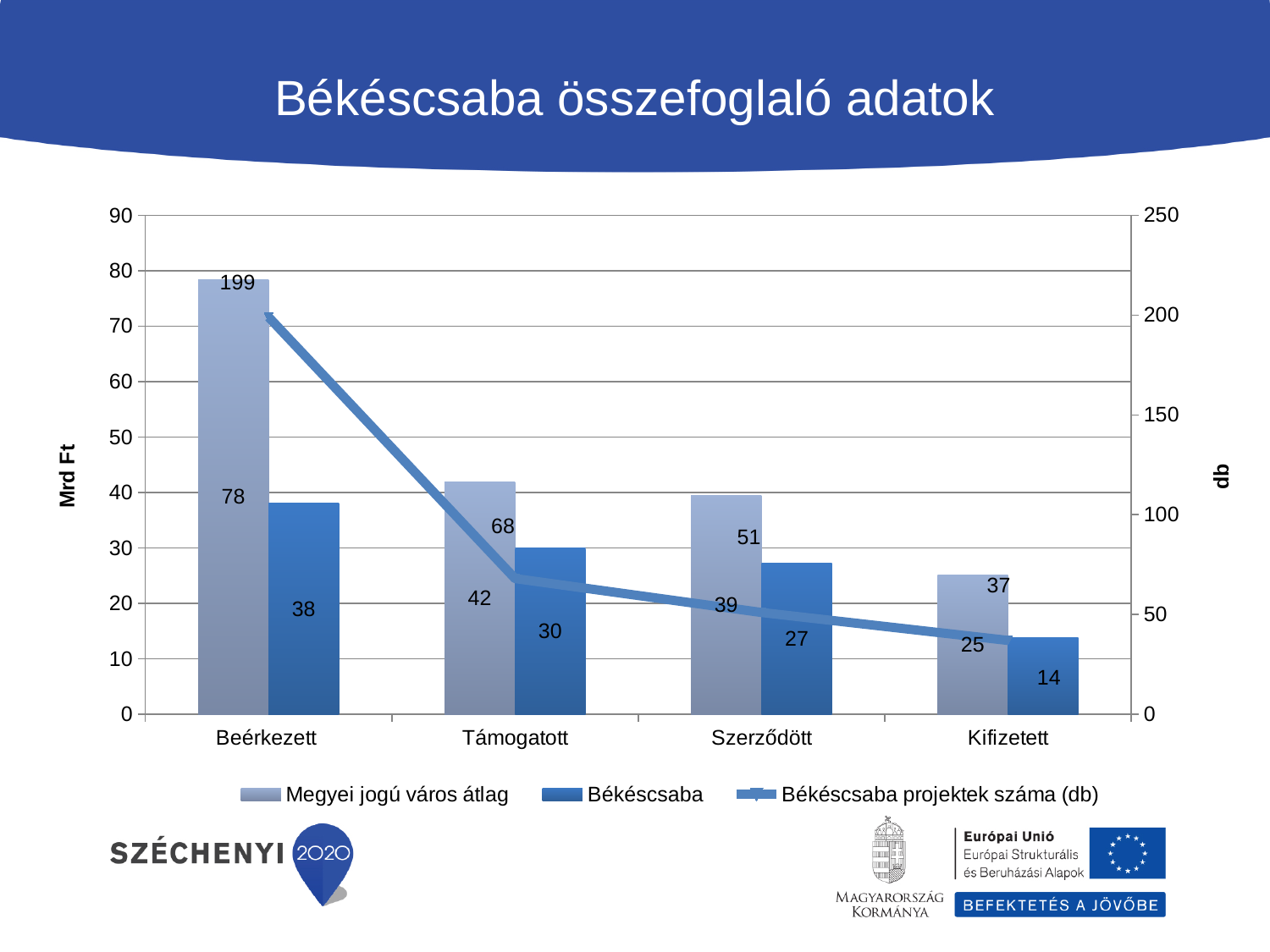
In which category is the Békéscsaba projektek száma (db) line highest? Beérkezett What is the value for Megyei jogú város átlag in the Beérkezett category? 78 Do the Békéscsaba projektek száma (db) values rise or fall from Beérkezett to Kifizetett? fall How many categories are shown on the x axis? 4 What is the value for Békéscsaba in the Kifizetett category? 14 How many projects (Békéscsaba projektek száma) are shown for the Támogatott category? 68 What is the label of the left vertical axis? Mrd Ft In which category is the Békéscsaba bar lowest? Kifizetett What is the difference between the Megyei jogú város átlag and Békéscsaba values in the Beérkezett category? 40 What is the value for Békéscsaba in the Szerződött category? 27 Which is larger in the Támogatott category: Megyei jogú város átlag or Békéscsaba? Megyei jogú város átlag How many series does the legend list? 3